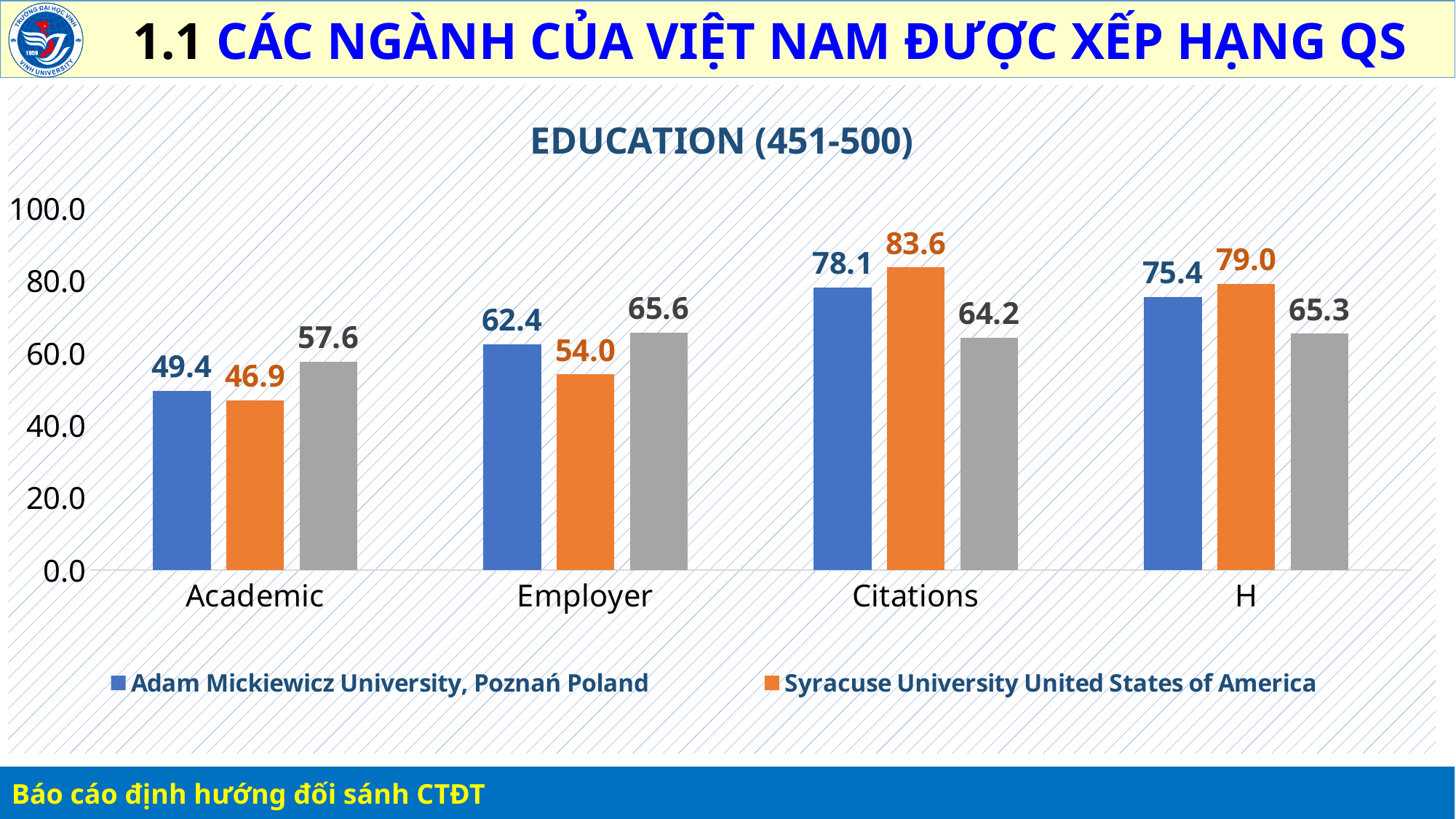
In which category does Adam Mickiewicz University, Poznań Poland have its lowest value? Academic What kind of chart is shown on the slide? Bar chart What is the value for Syracuse University United States of America in the Employer category? 54.0 What is the value for Adam Mickiewicz University, Poznań Poland in the Citations category? 78.1 What is the value for Adam Mickiewicz University, Poznań Poland in the H category? 75.4 Is the value for Syracuse University United States of America in the Academic category greater or less than 60.0? less How many categories are shown on the x axis? 4 In the Employer category, which is larger: the value for Adam Mickiewicz University, Poznań Poland or the value for Syracuse University United States of America? Adam Mickiewicz University, Poznań Poland What is the title of the chart? EDUCATION (451-500) In which category does Syracuse University United States of America have its highest value? Citations What is the difference between the Syracuse University and Adam Mickiewicz University values in the Citations category? 5.5 How many series does the legend list? 2